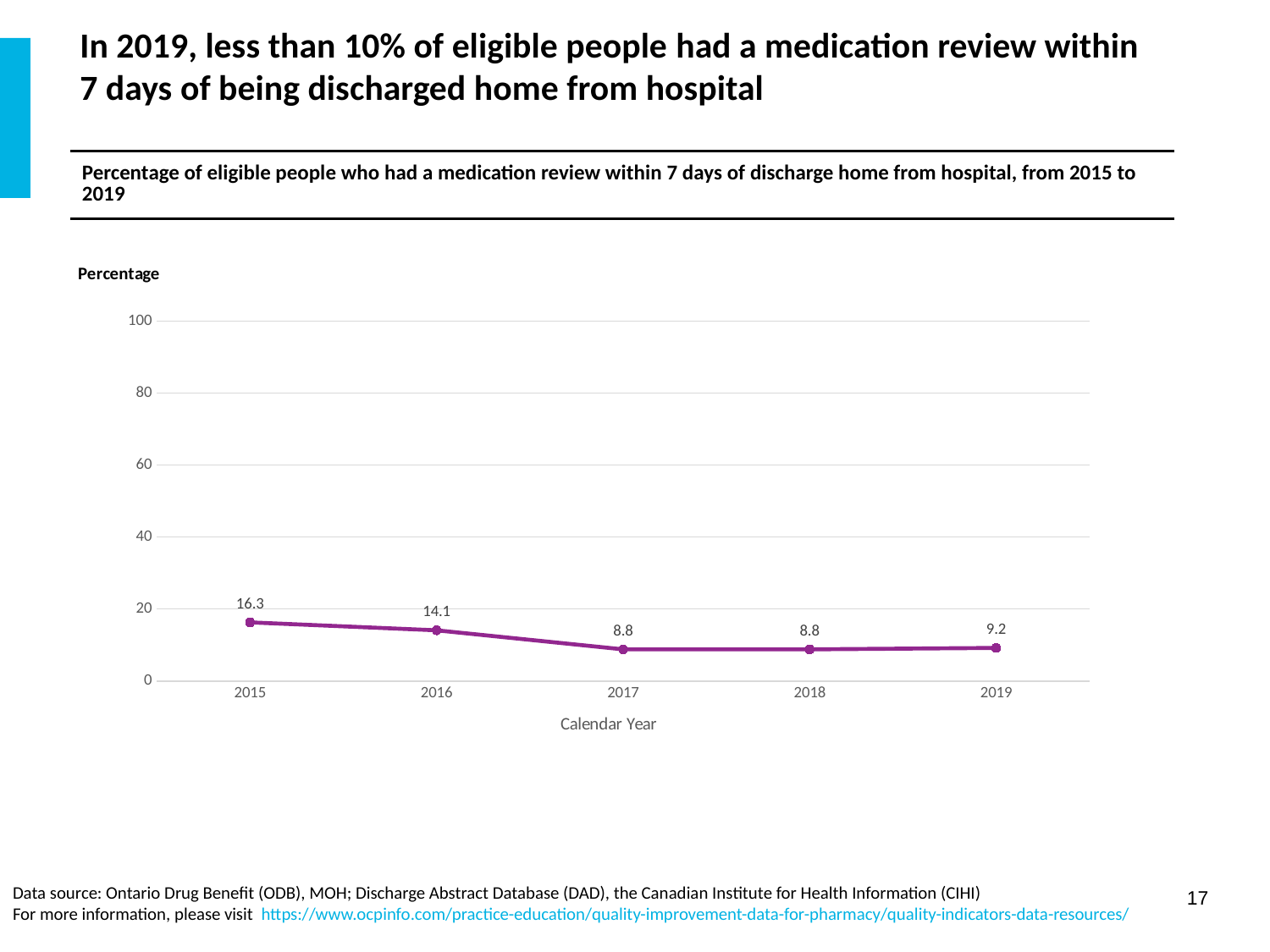
What kind of chart is shown on the slide? line chart How many years are plotted on the chart? 5 Do the values generally rise or fall from 2015 to 2017? fall What is the label of the x axis? Calendar Year Which year has the highest percentage? 2015 Which is larger, the value for 2018 or the value for 2019? 2019 What is the difference between the 2015 value and the 2019 value? 7.1 What is the percentage value for 2016? 14.1 What is the percentage value for 2019? 9.2 What is the percentage value for 2015? 16.3 Is the value for 2015 greater or less than 20? less What is the difference between the 2016 value and the 2017 value? 5.3